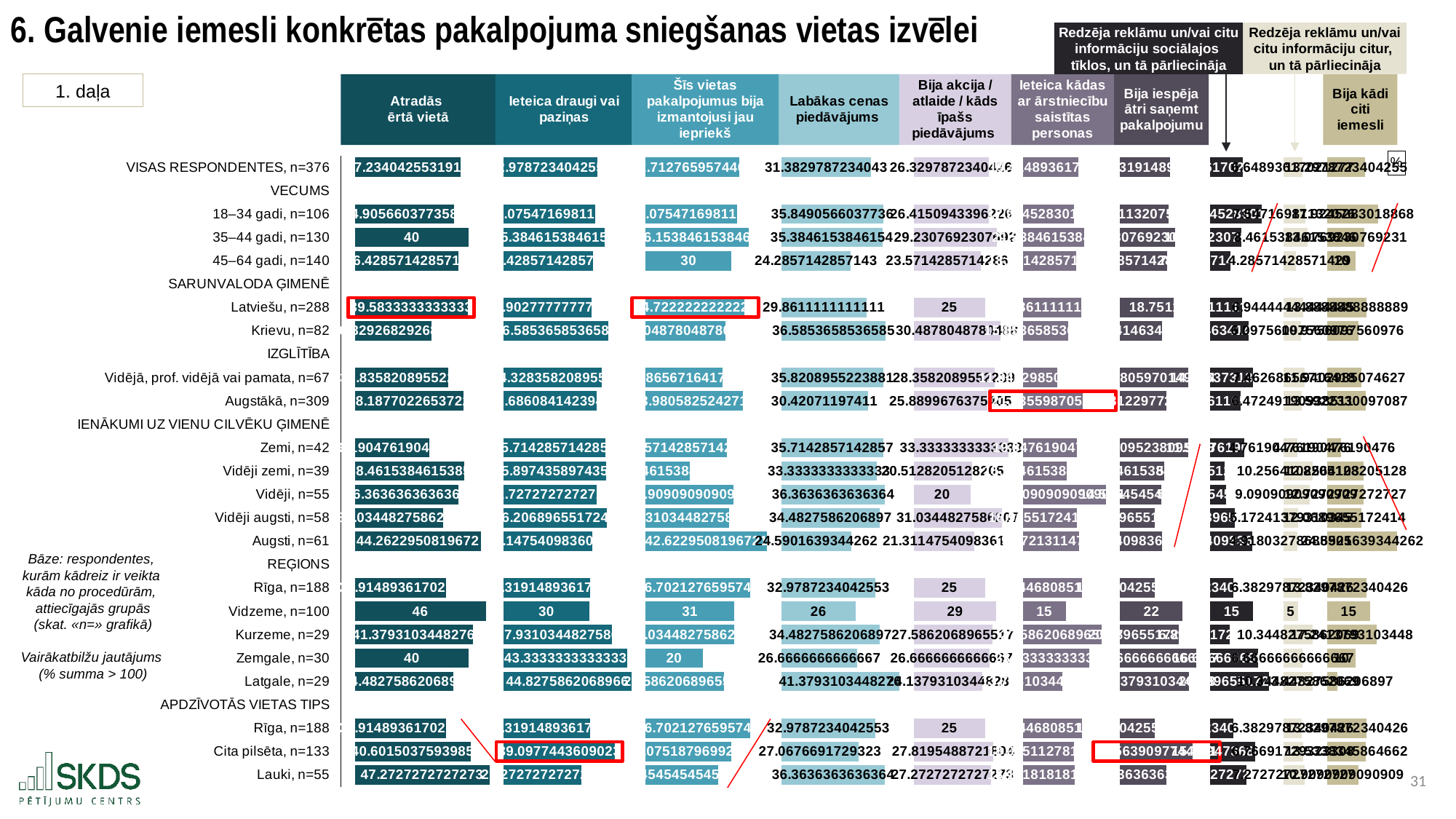
What is the value for Vidzeme, n=100 in the 'Ieteica kādas ar ārstniecību saistītas personas' series? 15 What is the value for Zemgale, n=30 in the 'Ieteica draugi vai paziņas' series? 43.3333333333333 What is the value for Vidzeme, n=100 in the 'Bija iespēja ātri saņemt pakalpojumu' series? 22 What is the value for Vidzeme, n=100 in the 'Bija akcija / atlaide / kāds īpašs piedāvājums' series? 29 For Vidzeme, n=100, what is the difference between 'Atradās ērtā vietā' and 'Ieteica draugi vai paziņas'? 16 What kind of chart is shown on the slide? bar chart For Vidzeme, n=100, which is larger: 'Labākas cenas piedāvājums' or 'Bija akcija / atlaide / kāds īpašs piedāvājums'? Bija akcija / atlaide / kāds īpašs piedāvājums What is the value for Vidzeme, n=100 in the 'Atradās ērtā vietā' series? 46 What is the value for Latviešu, n=288 in the 'Bija iespēja ātri saņemt pakalpojumu' series? 18.75 What is the value for Vidzeme, n=100 in the 'Labākas cenas piedāvājums' series? 26 For Vidzeme, n=100, which series has the highest value? Atradās ērtā vietā What is the value for Vidzeme, n=100 in the 'Ieteica draugi vai paziņas' series? 30